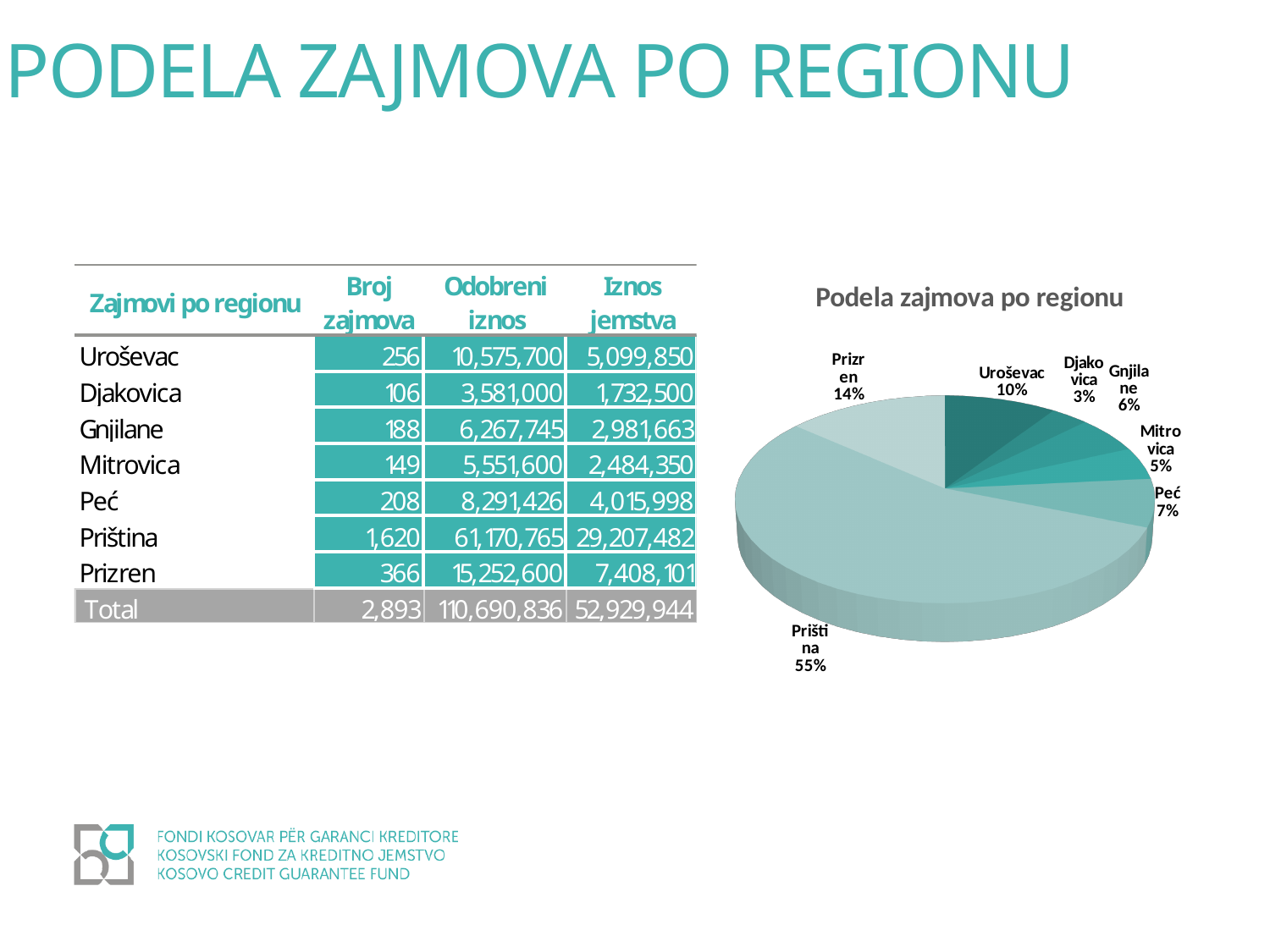
What share of the pie does Mitrovica have? 5% What kind of chart is shown on the slide? pie chart Which region has the largest slice of the pie? Priština What is the title of the chart? Podela zajmova po regionu What share of the pie does Prizren have? 14% What share of the pie does Priština have? 55% What is the difference in percentage points between the shares of Prizren and Uroševac? 4% Which has a larger share of the pie, Peć or Gnjilane? Peć How many regions (slices) are shown in the pie chart? 7 Which region has the smallest slice of the pie? Djakovica